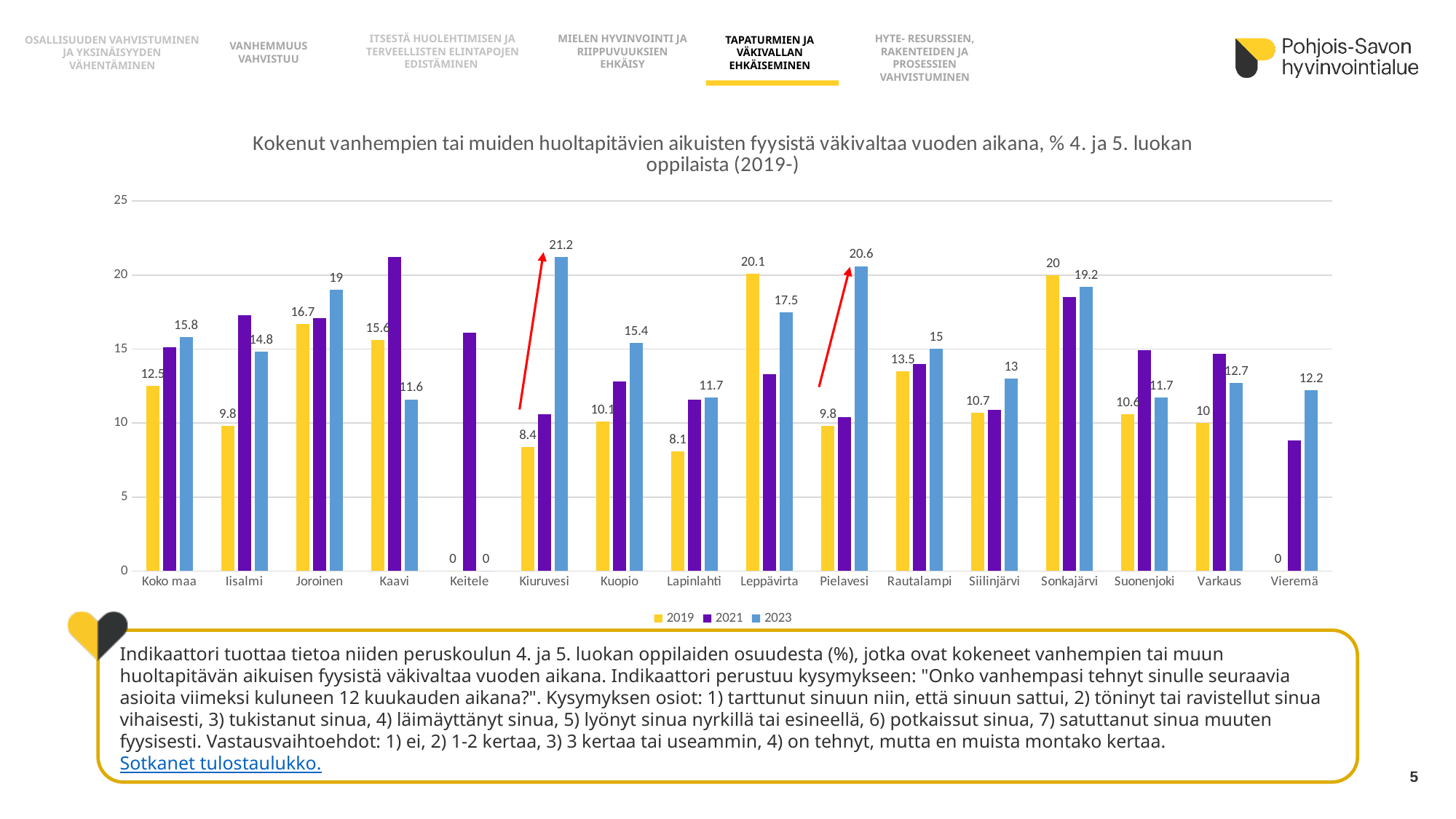
What is the difference between the 2023 and 2019 values for Pielavesi? 10.8 How many series does the legend list? 3 What is the 2019 value for Leppävirta? 20.1 Is the 2021 value for Kaavi greater or less than 20? greater How many categories (areas) are shown on the x axis? 16 Which is larger for Kaavi: the 2019 value or the 2023 value? 2019 What type of chart is shown on the slide? bar chart Which area has the highest 2023 value? Kiuruvesi What is the 2023 value for Kiuruvesi? 21.2 What is the 2023 value for Koko maa? 15.8 Which colour represents the 2019 series in the legend? yellow Is the 2021 value for Vieremä greater or less than 10? less